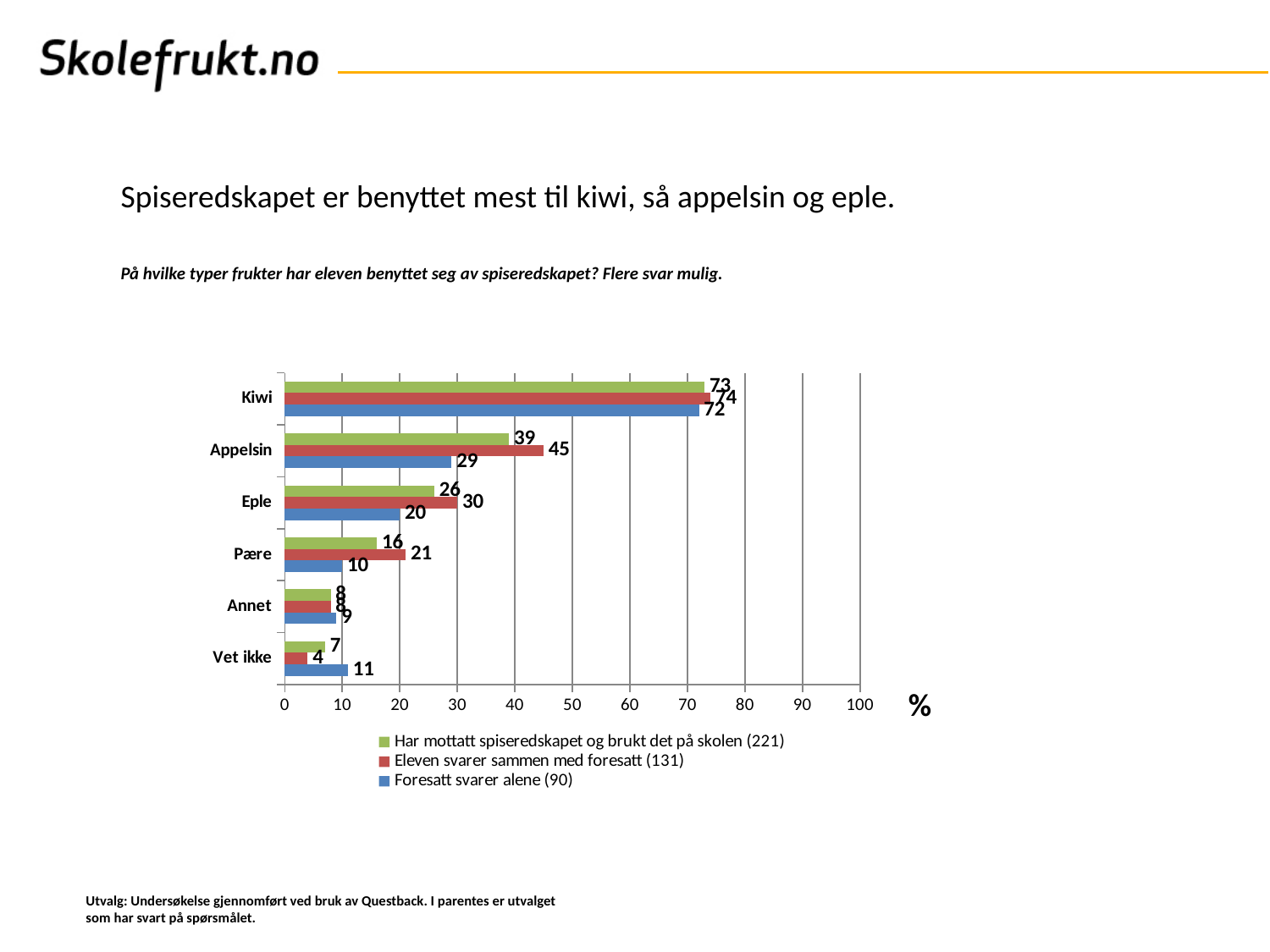
How many series does the legend list? 3 Which category has the highest value in the series 'Har mottatt spiseredskapet og brukt det på skolen (221)'? Kiwi What is the value for Vet ikke in the series 'Foresatt svarer alene (90)'? 11 What is the value for Appelsin in the series 'Eleven svarer sammen med foresatt (131)'? 45 What kind of chart is shown on the slide? bar chart For Appelsin, what is the difference between the 'Eleven svarer sammen med foresatt (131)' value and the 'Foresatt svarer alene (90)' value? 16 Is the value for Kiwi in the series 'Foresatt svarer alene (90)' greater or less than 50? greater How many categories are shown on the chart? 6 What is the value for Eple in the series 'Foresatt svarer alene (90)'? 20 What is the value for Pære in the series 'Har mottatt spiseredskapet og brukt det på skolen (221)'? 16 Which category has the lowest value in the series 'Eleven svarer sammen med foresatt (131)'? Vet ikke For Eple, which series has the larger value: 'Har mottatt spiseredskapet og brukt det på skolen (221)' or 'Eleven svarer sammen med foresatt (131)'? Eleven svarer sammen med foresatt (131)